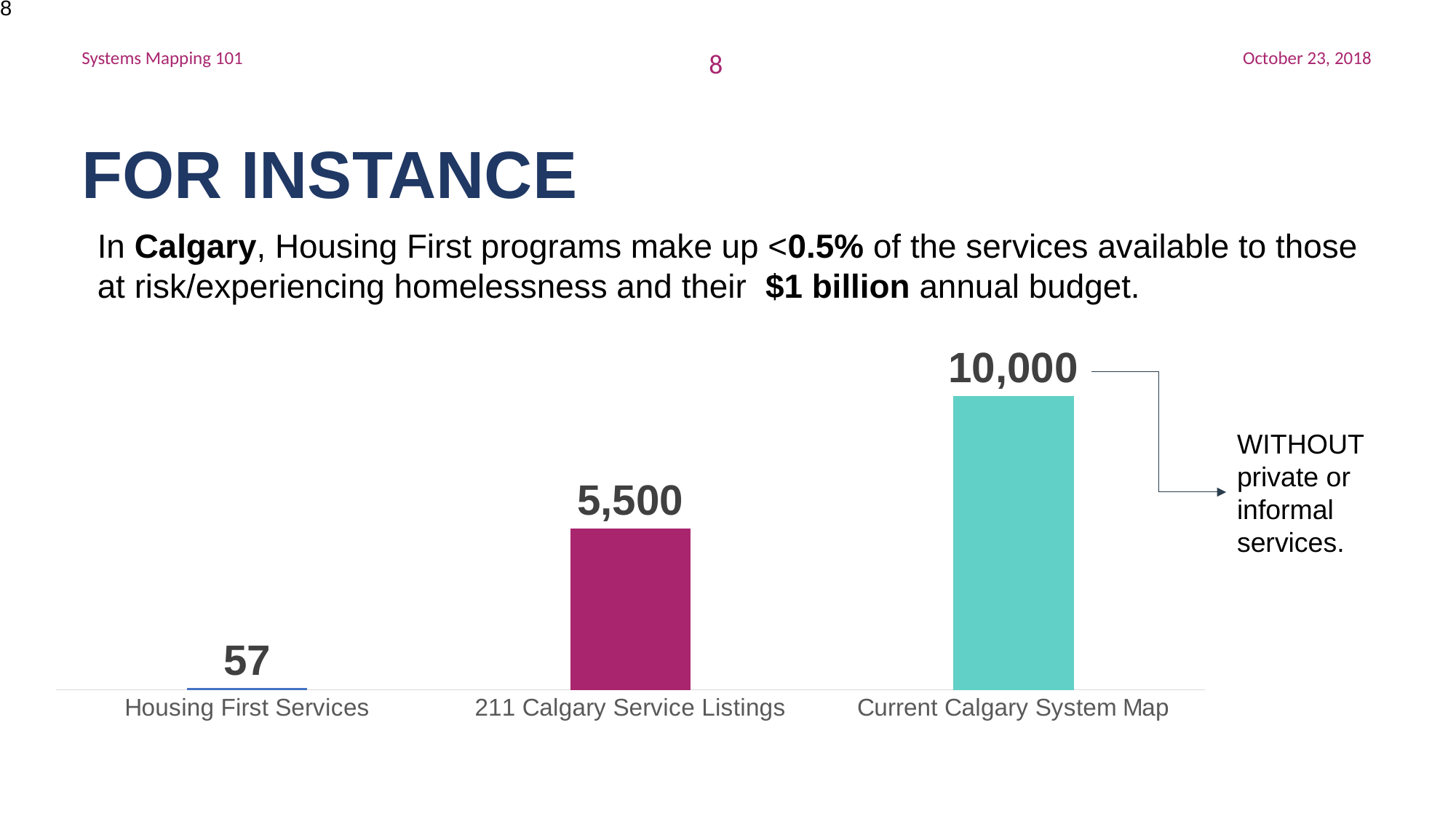
What is the difference between the values for Current Calgary System Map and 211 Calgary Service Listings? 4,500 What is the value for 211 Calgary Service Listings? 5,500 How many categories are shown in the chart? 3 Which category has the lowest value? Housing First Services What kind of chart is shown on the slide? Bar chart What is the value for Housing First Services? 57 Do the values rise or fall from left to right across the categories? Rise Which category has the highest value? Current Calgary System Map Which is larger, the value for 211 Calgary Service Listings or the value for Housing First Services? 211 Calgary Service Listings What is the value for Current Calgary System Map? 10,000 What colour is the bar for Current Calgary System Map? Teal What is the difference between the values for 211 Calgary Service Listings and Housing First Services? 5,443